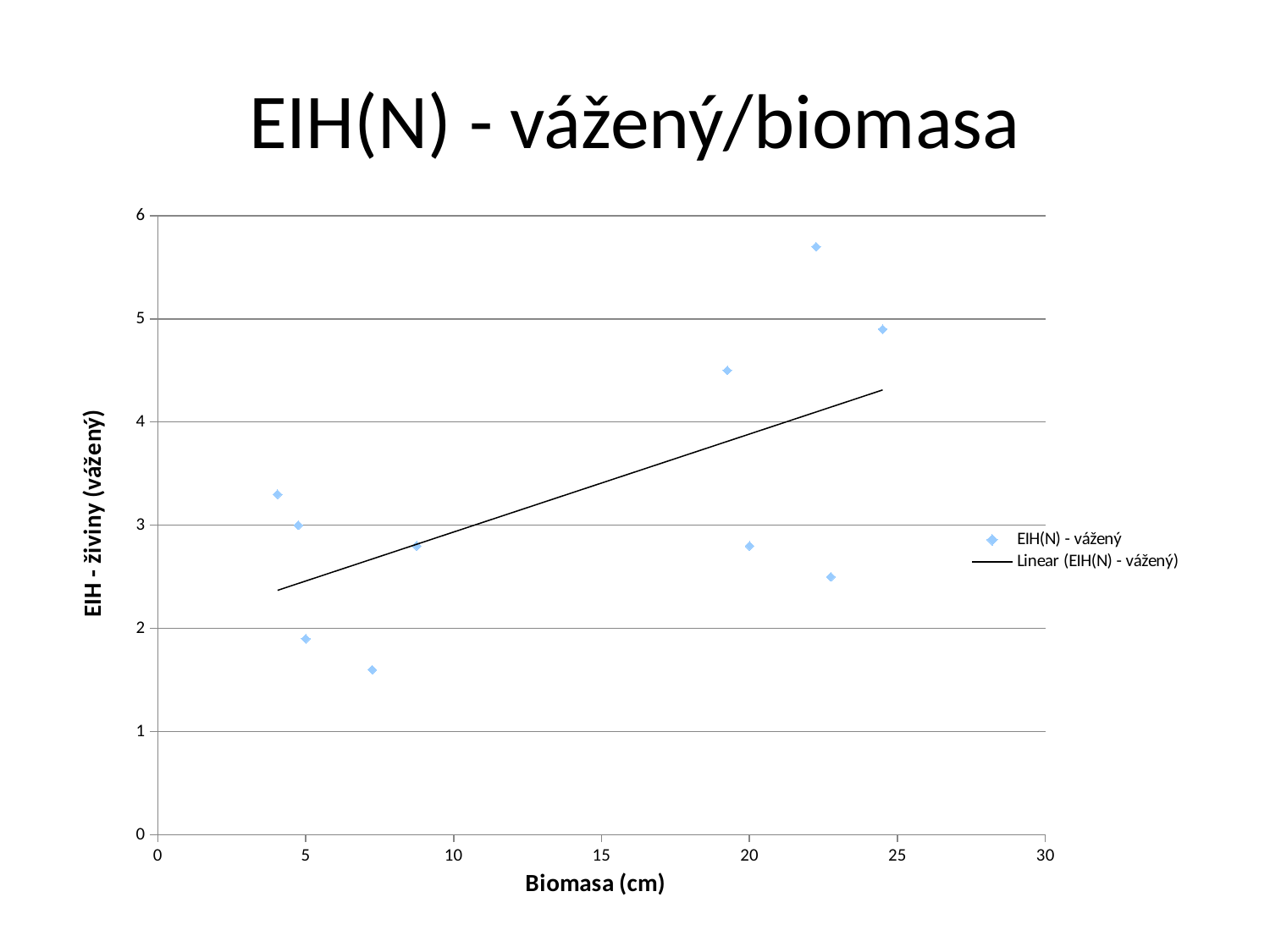
Is the value of the data point with the smallest Biomasa greater or less than 3? greater How many data points are plotted in the chart? 10 What is the title of the chart? EIH(N) - vážený/biomasa Is the value of the lowest data point greater or less than 2? less Is the value of the data point with the largest Biomasa greater or less than 4? greater How many entries does the legend list? 2 Does the linear trendline rise or fall as Biomasa increases? rises What kind of chart is shown on the slide? scatter chart What is the label of the x axis? Biomasa (cm)